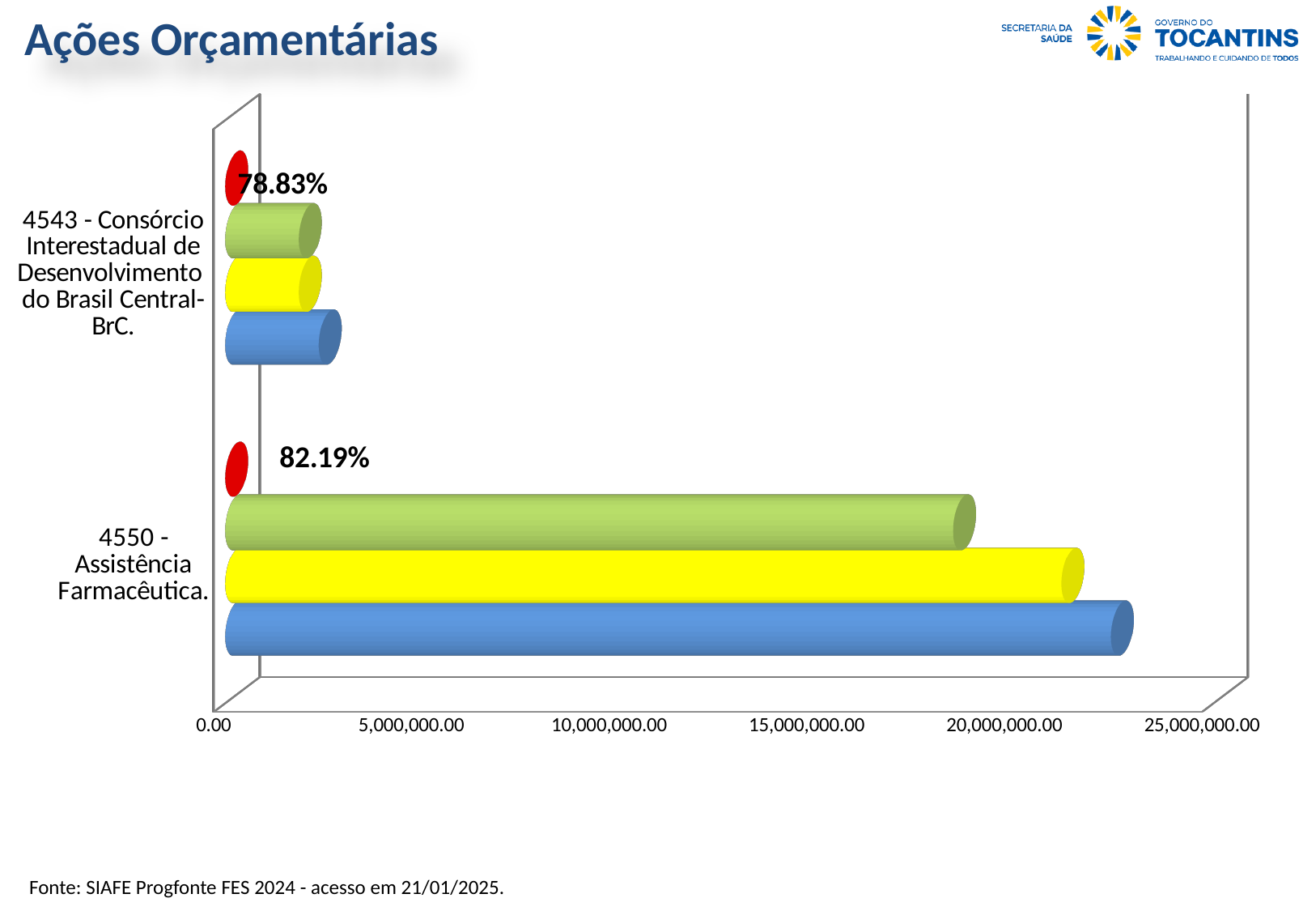
What is the maximum value shown on the horizontal axis of the chart? 25,000,000.00 Is the value of the green bar for '4550 - Assistência Farmacêutica.' greater or less than 20,000,000.00? less Which category has the longer blue bar, '4543 - Consórcio Interestadual de Desenvolvimento do Brasil Central-BrC.' or '4550 - Assistência Farmacêutica.'? 4550 - Assistência Farmacêutica. What percentage is labelled for the category '4543 - Consórcio Interestadual de Desenvolvimento do Brasil Central-BrC.'? 78.83% What percentage is labelled for the category '4550 - Assistência Farmacêutica.'? 82.19% What is the title of the chart on the slide? Ações Orçamentárias Which category has the higher percentage label? 4550 - Assistência Farmacêutica. Is the value of the blue bar for '4543 - Consórcio Interestadual de Desenvolvimento do Brasil Central-BrC.' greater or less than 5,000,000.00? less What type of chart is shown on the slide? bar chart How many categories (budget actions) are shown on the chart? 2 Is the value of the blue bar for '4550 - Assistência Farmacêutica.' greater or less than 20,000,000.00? greater What is the difference between the percentage labels of '4550 - Assistência Farmacêutica.' and '4543 - Consórcio Interestadual de Desenvolvimento do Brasil Central-BrC.'? 3.36 percentage points